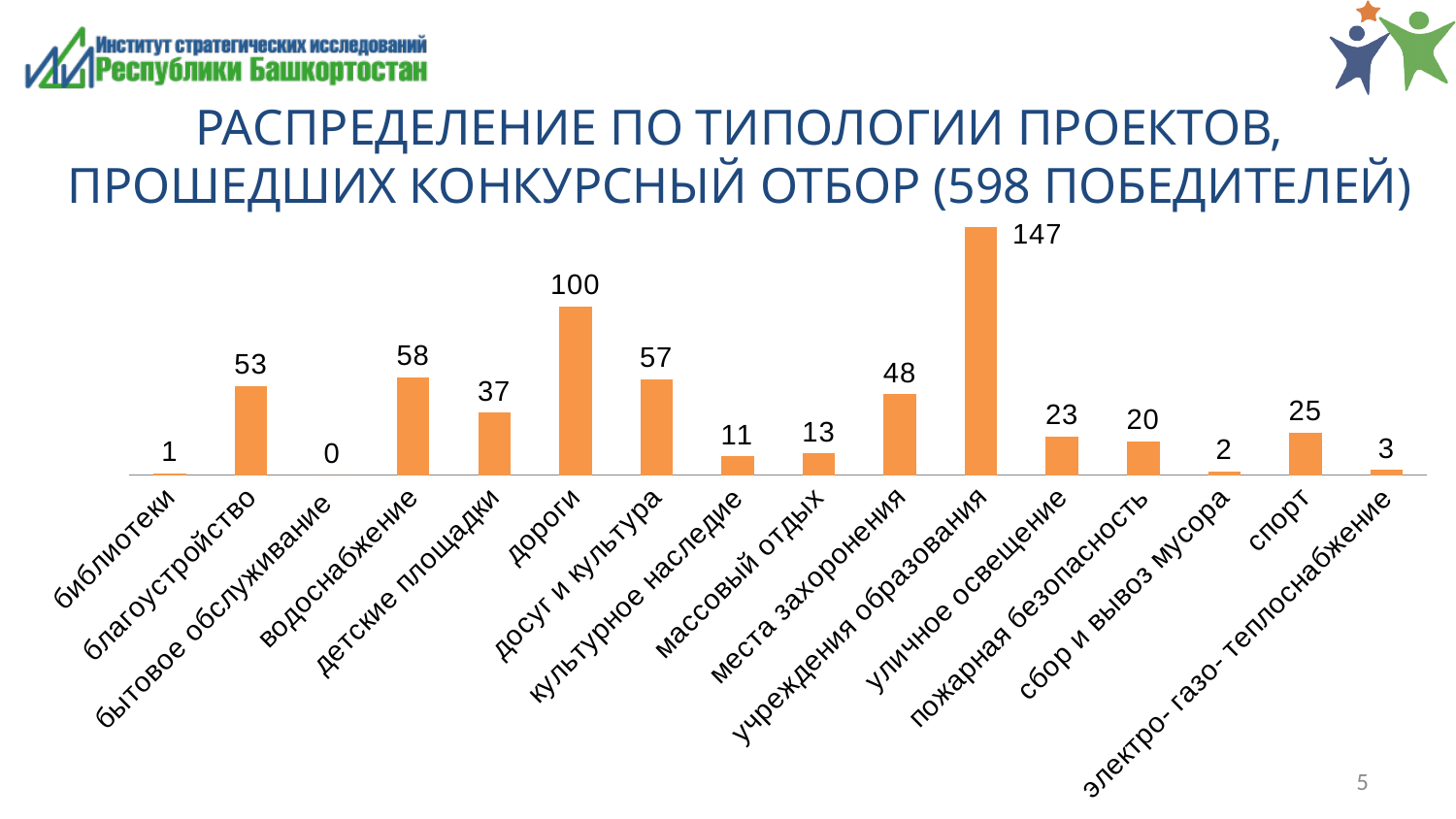
What type of chart is shown on the slide? bar chart What is the difference between the values for учреждения образования and дороги? 47 Which category has the lowest value? бытовое обслуживание How many categories are shown on the x axis? 16 What is the value for уличное освещение? 23 What is the value for места захоронения? 48 What is the difference between the values for водоснабжение and благоустройство? 5 What is the value for дороги? 100 Which is larger, the value for спорт or the value for пожарная безопасность? спорт What is the value for детские площадки? 37 What is the value for сбор и вывоз мусора? 2 Which category has the highest value? учреждения образования